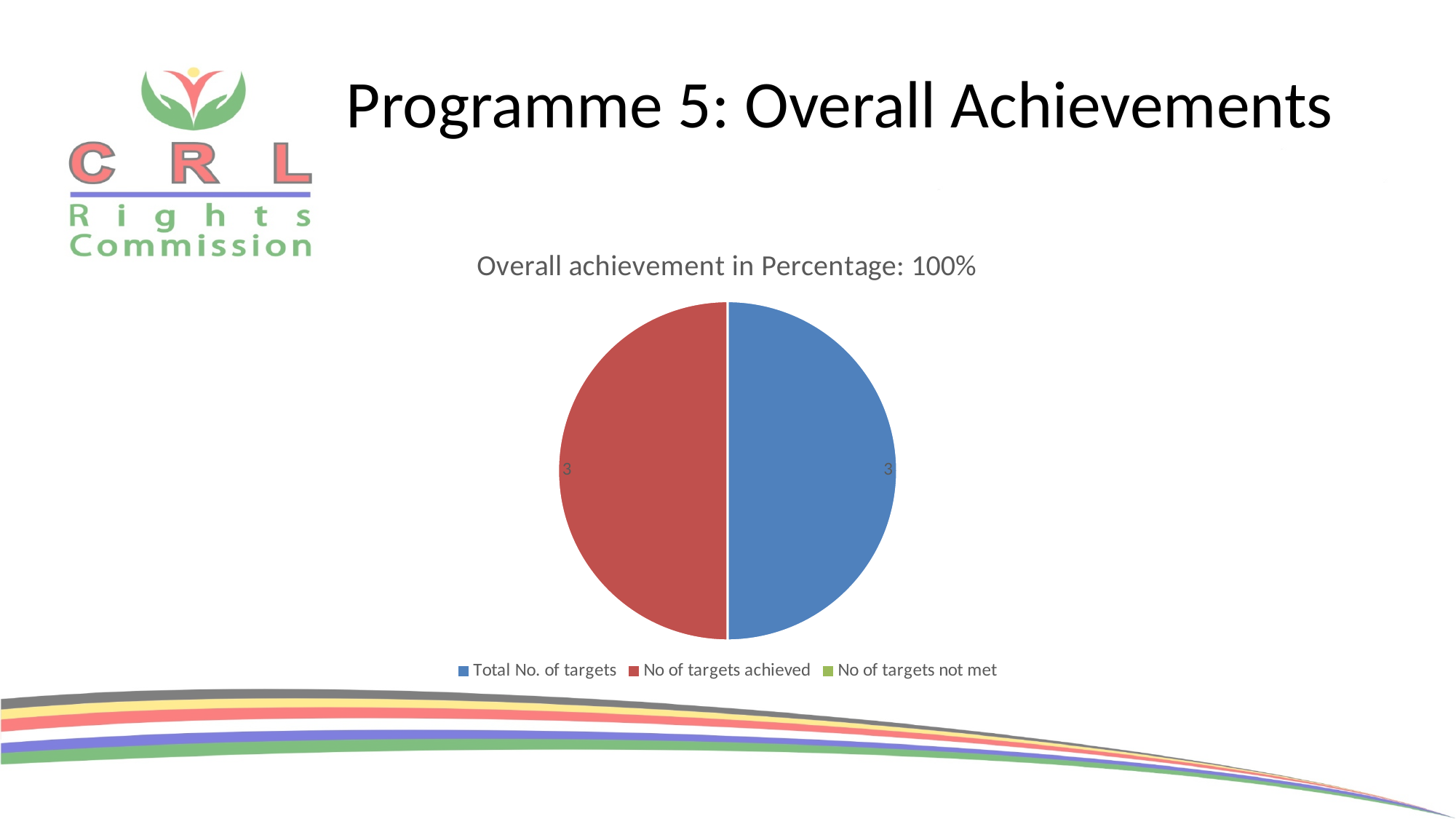
How many slices are visible in the pie chart? 2 How many entries does the legend of the pie chart list? 3 What kind of chart is shown on the slide? pie chart What is the value for Total No. of targets in the pie chart? 3 What is the value for No of targets achieved in the pie chart? 3 What is the difference between the value for Total No. of targets and the value for No of targets achieved? 0 What is the title of the pie chart? Overall achievement in Percentage: 100% Which colour represents No of targets achieved in the pie chart? red